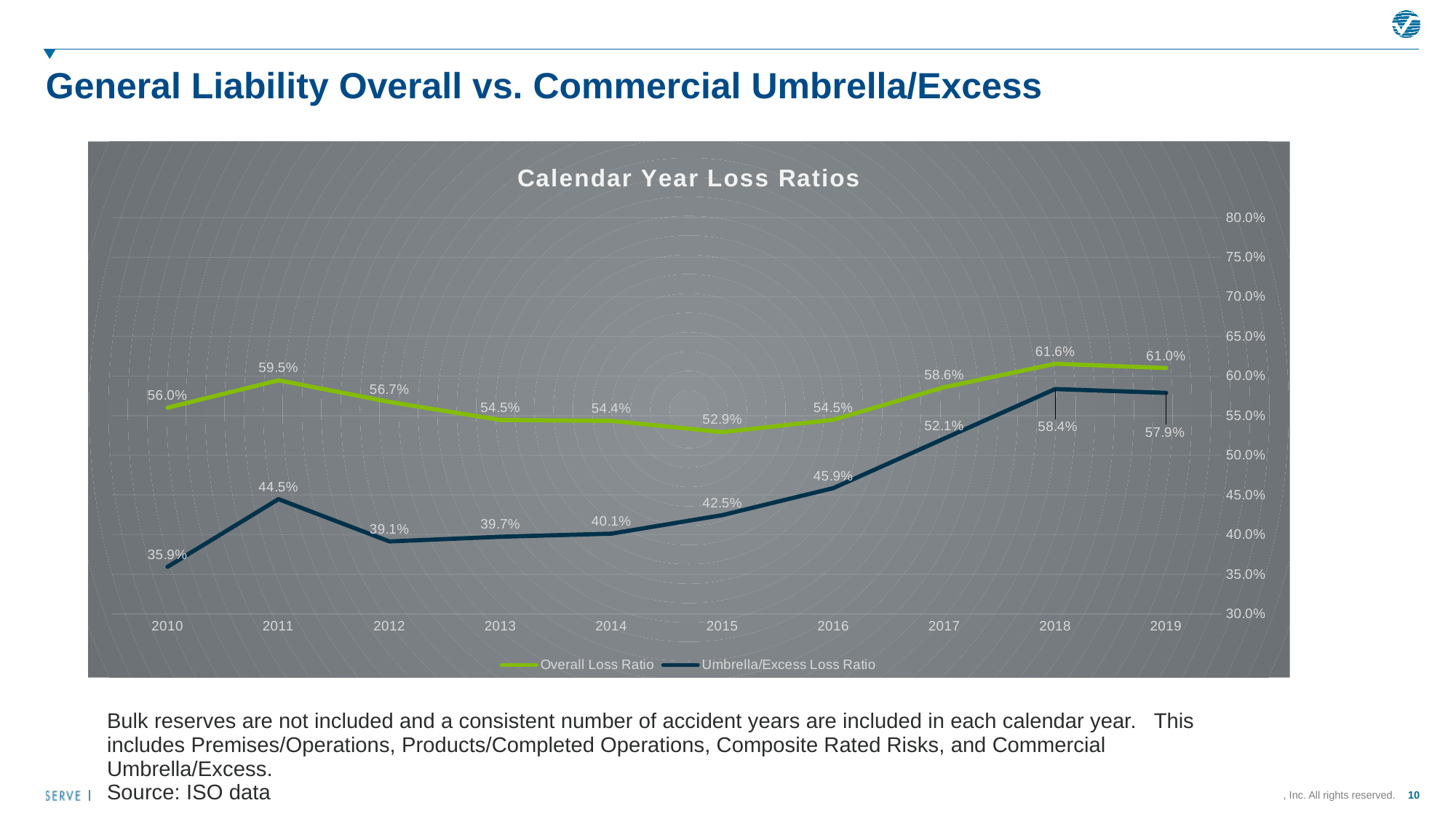
What kind of chart is shown on the slide? Line chart What is the Umbrella/Excess Loss Ratio for 2010? 35.9% How many series does the legend list? 2 In which year is the Overall Loss Ratio lowest? 2015 In which year is the Overall Loss Ratio highest? 2018 What is the Umbrella/Excess Loss Ratio for 2016? 45.9% What is the Overall Loss Ratio for 2011? 59.5% Does the Umbrella/Excess Loss Ratio rise or fall from 2012 to 2018? Rise Which series has the higher value in 2018, Overall Loss Ratio or Umbrella/Excess Loss Ratio? Overall Loss Ratio What is the difference between the Overall Loss Ratio and the Umbrella/Excess Loss Ratio in 2010? 20.1% In which year is the Umbrella/Excess Loss Ratio lowest? 2010 How many years are shown on the x axis? 10